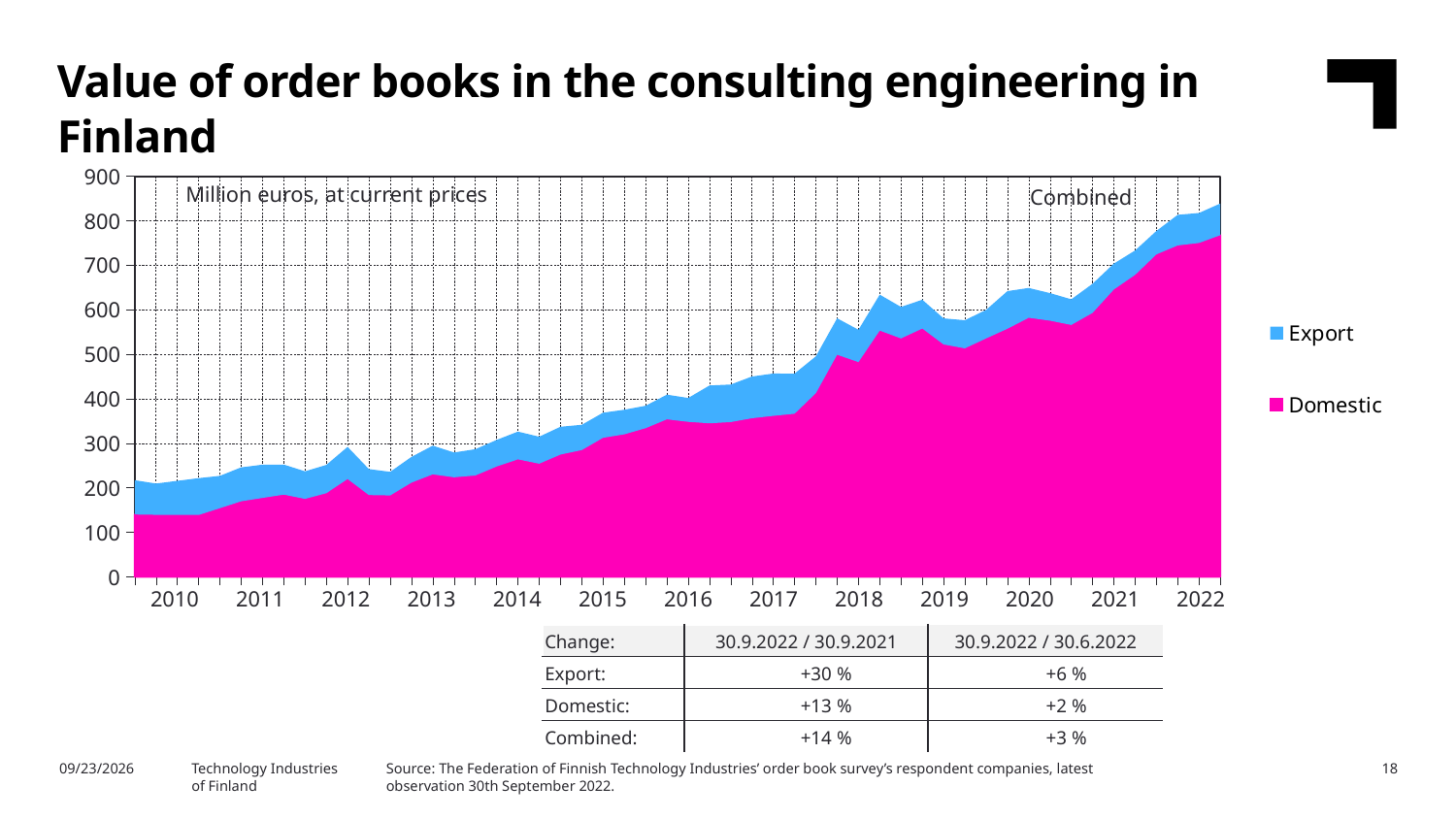
How many years are labelled on the x axis? 13 Which series is larger in 2022, Export or Domestic? Domestic Is the combined value in 2018 greater or less than 500? greater What kind of chart is shown on the slide? Area chart Is the Domestic value at the start of 2010 greater or less than 200? less Is the Domestic value at the end of 2022 greater or less than 700? greater What unit is stated on the chart for the values? Million euros, at current prices Does the combined value of order books generally rise or fall from 2010 to 2022? Rise Which two series are listed in the legend? Export and Domestic How many series does the legend list? 2